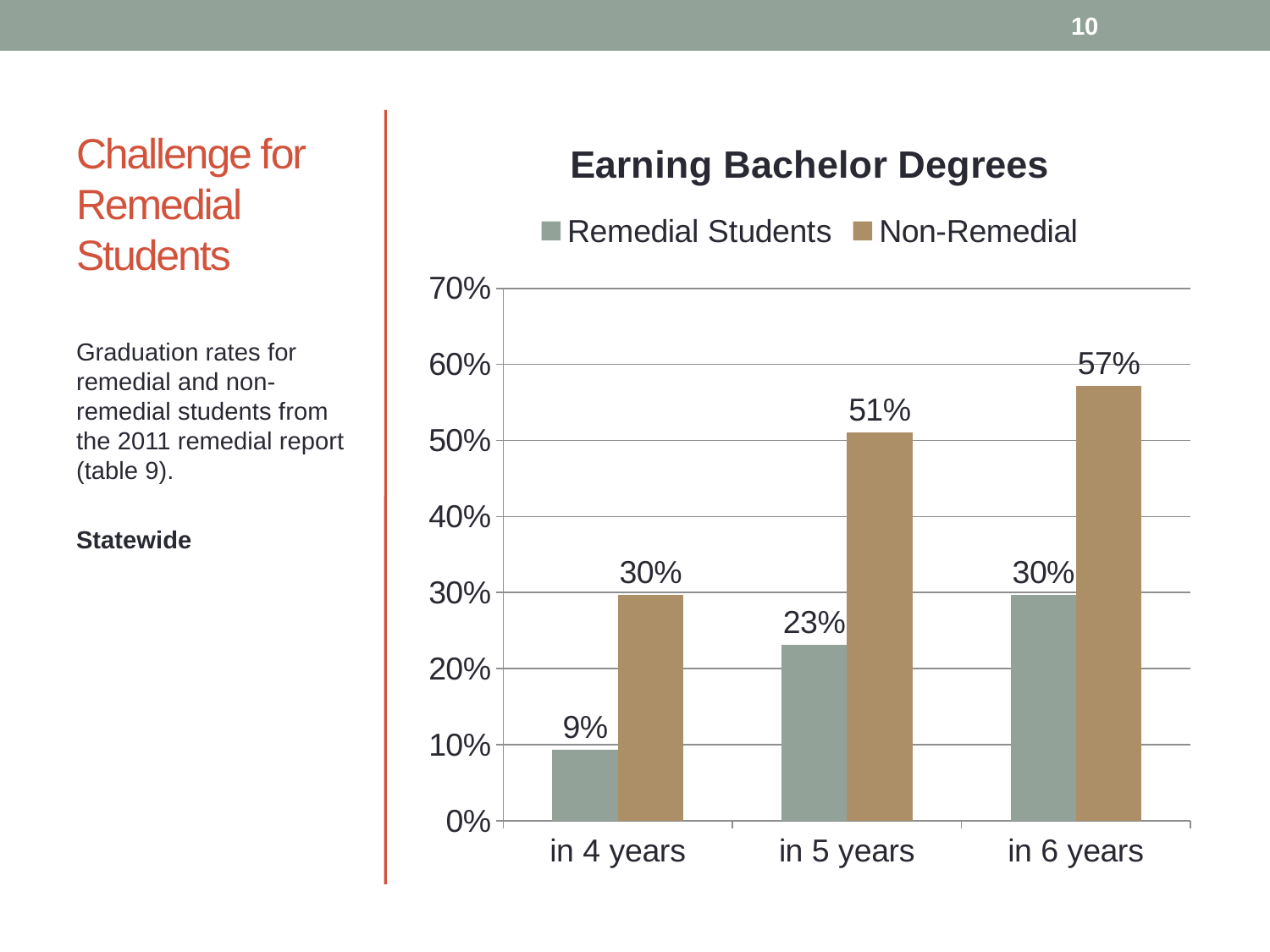
Which is larger: the Non-Remedial value in 4 years or the Remedial Students value in 6 years? They are equal (30%) What kind of chart is shown? bar chart What is the difference between the Non-Remedial and Remedial Students values in 5 years? 28% What is the value for Non-Remedial in 5 years? 51% Which category has the highest Non-Remedial value? in 6 years How many series does the legend list? 2 Which category has the lowest Remedial Students value? in 4 years What is the value for Remedial Students in 4 years? 9% What is the value for Remedial Students in 6 years? 30% Do the Remedial Students values rise or fall from 4 years to 6 years? rise How many categories are shown on the x axis? 3 Is the Non-Remedial value in 6 years greater or less than 50%? greater